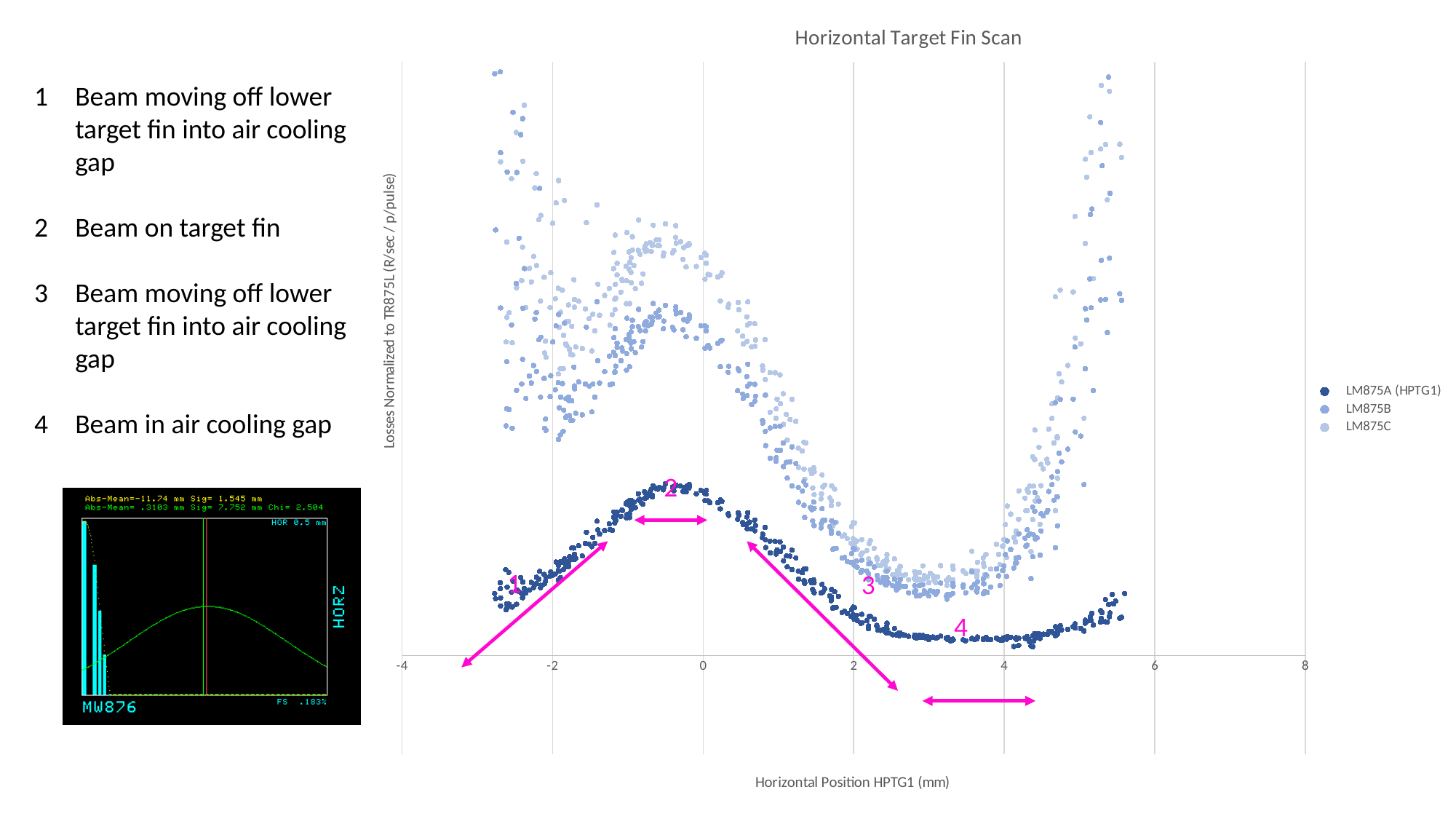
How many series does the legend of the Horizontal Target Fin Scan chart list? 3 What kind of chart is shown on the slide? Scatter chart Does the LM875A (HPTG1) series rise or fall as the horizontal position goes from -3 mm to -1 mm? Rise Do the LM875B and LM875C series rise or fall as the horizontal position goes from 4 mm to 5 mm? Rise Is the horizontal position at which the LM875A (HPTG1) series reaches its minimum greater or less than 2 mm? greater Which series in the chart reaches the highest loss values at the right-hand end of the scan (around 5 mm)? LM875C What is the label of the x axis of the chart? Horizontal Position HPTG1 (mm) What is the lowest value shown on the x axis of the chart? -4 What is the title of the chart on the slide? Horizontal Target Fin Scan Which series in the chart has the lowest loss values across the whole scan? LM875A (HPTG1) Does the LM875A (HPTG1) series rise or fall as the horizontal position goes from 0 mm to 3 mm? Fall At a horizontal position of 0 mm, which series has the larger loss value, LM875A (HPTG1) or LM875C? LM875C